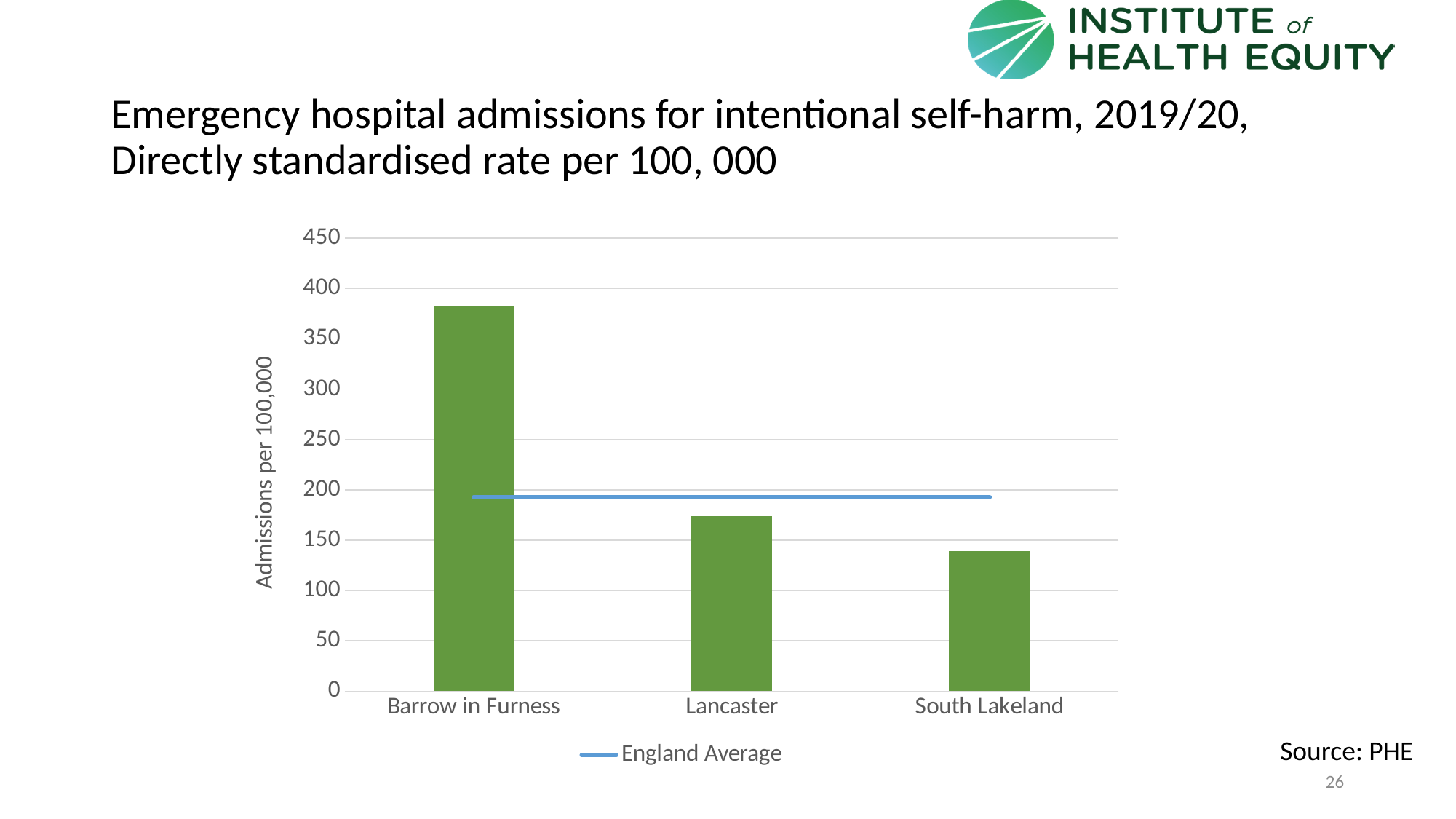
What is the label on the chart's vertical axis? Admissions per 100,000 Is the value for Lancaster greater or less than 200? less Which has the higher admission rate, Barrow in Furness or Lancaster? Barrow in Furness Which area has the highest rate of emergency hospital admissions for intentional self-harm? Barrow in Furness Do the bar values rise or fall from left to right across the x axis? fall How many entries does the chart's legend list? 1 Is the value for Barrow in Furness greater or less than 350? greater Is the England Average line greater or less than 150? greater How many areas are shown on the x axis of the chart? 3 What kind of chart is shown on the slide? bar chart Which area has the lowest rate of emergency hospital admissions for intentional self-harm? South Lakeland